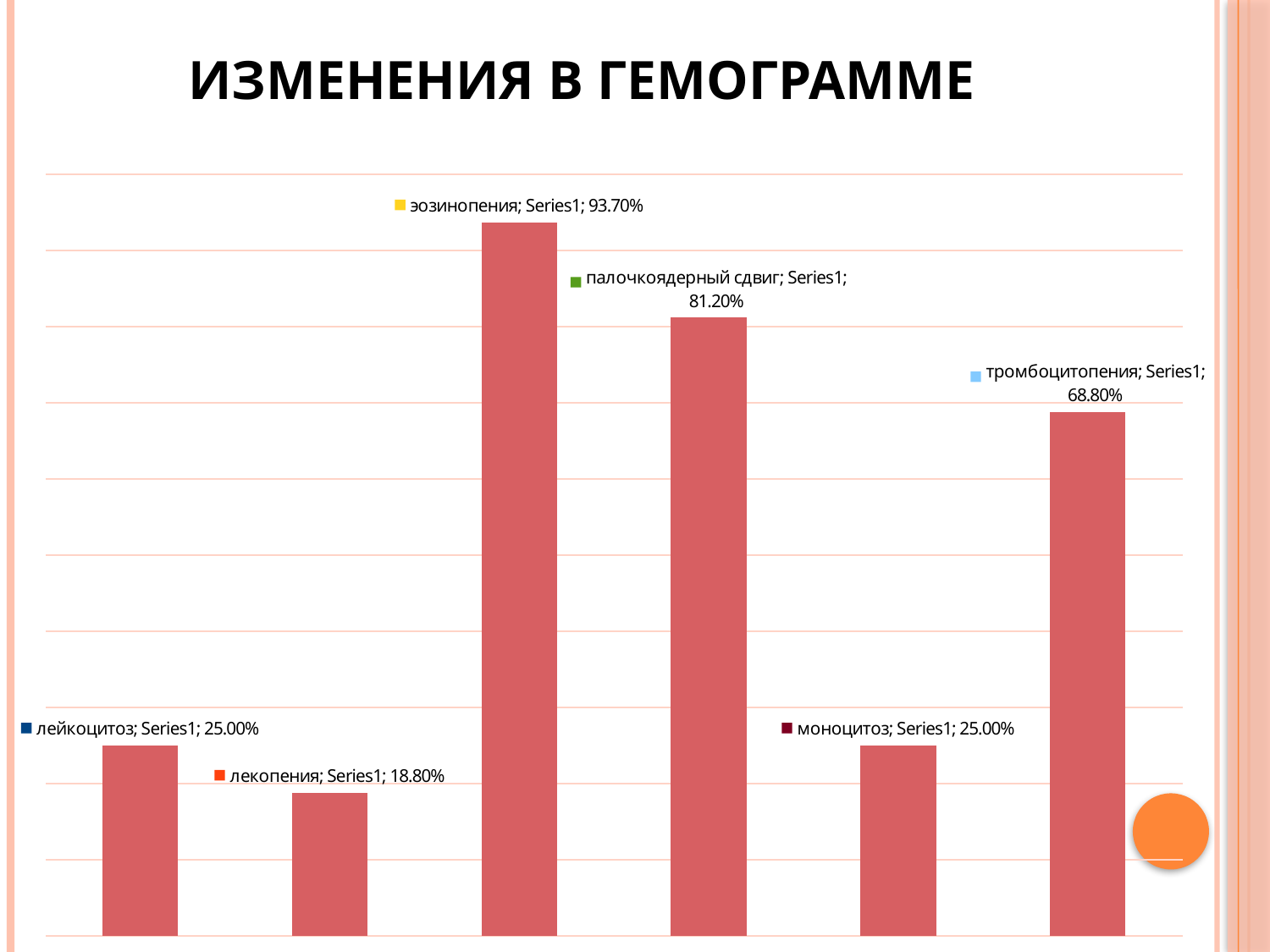
What is the value for эозинопения? 93.70% Which category has the highest value? эозинопения What is the value for палочкоядерный сдвиг? 81.20% What kind of chart is shown on the slide? bar chart Which is larger, the value for палочкоядерный сдвиг or the value for тромбоцитопения? палочкоядерный сдвиг What is the value for тромбоцитопения? 68.80% What is the title of the slide? ИЗМЕНЕНИЯ В ГЕМОГРАММЕ What is the value for лекопения? 18.80% What is the difference between the values for лейкоцитоз and лекопения? 6.20% Which category has the lowest value? лекопения What is the difference between the values for эозинопения and палочкоядерный сдвиг? 12.50% How many categories are shown in the chart? 6